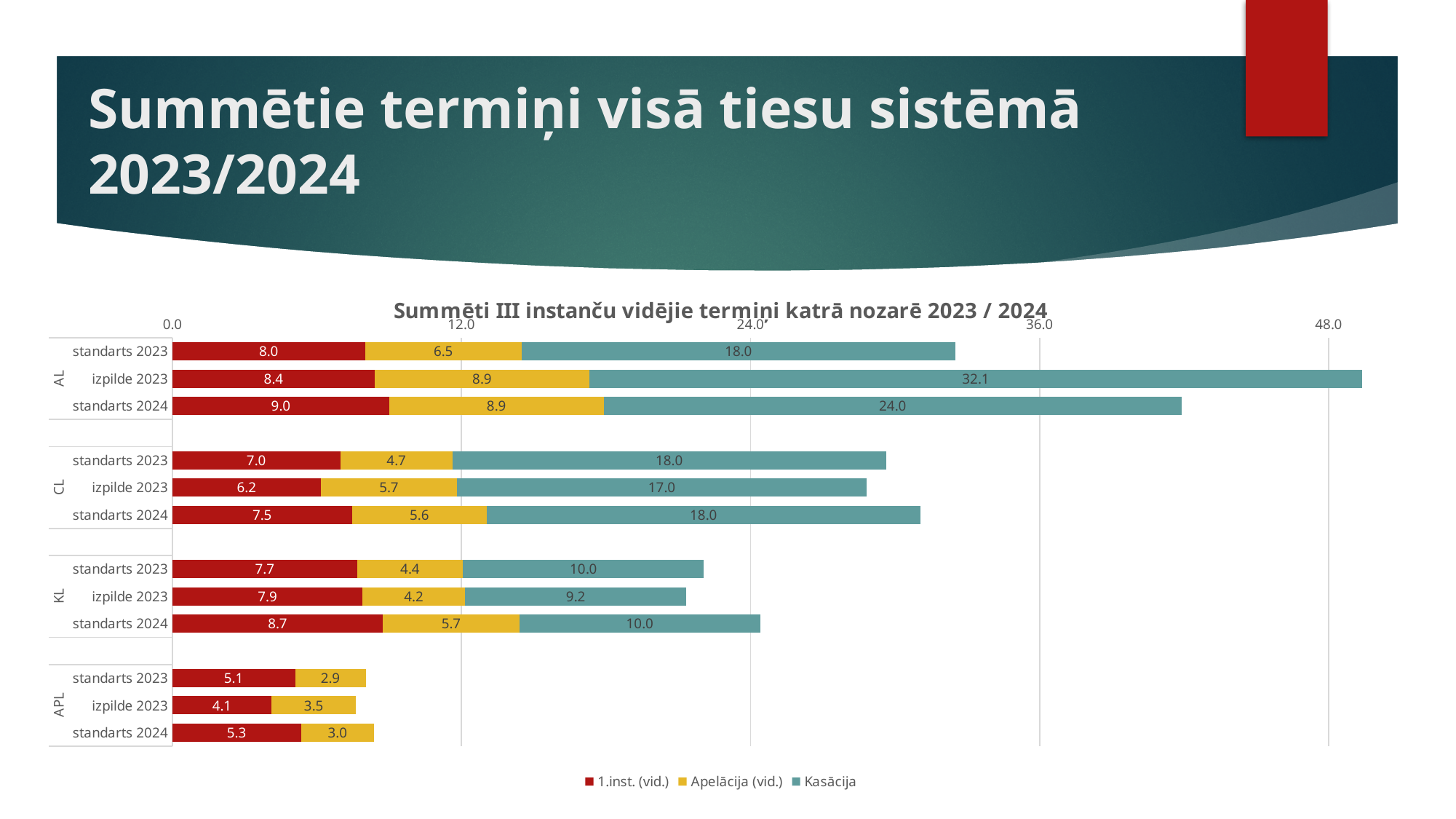
Which bar has the lowest 1.inst. (vid.) value? APL izpilde 2023 What is the total of the stacked bar for AL standarts 2023? 32.5 What is the total of the stacked bar for APL standarts 2024? 8.3 What is the Kasācija value for AL izpilde 2023? 32.1 What is the difference between the Kasācija values for AL standarts 2024 and AL standarts 2023? 6.0 Which bar has the highest Kasācija value? AL izpilde 2023 How many stacked bars are plotted in the chart? 12 What is the 1.inst. (vid.) value for KL standarts 2024? 8.7 Which is larger: the 1.inst. (vid.) value for CL standarts 2024 or for CL izpilde 2023? CL standarts 2024 How many series does the legend list? 3 What type of chart is shown on the slide? Stacked bar chart What is the Apelācija (vid.) value for CL standarts 2023? 4.7